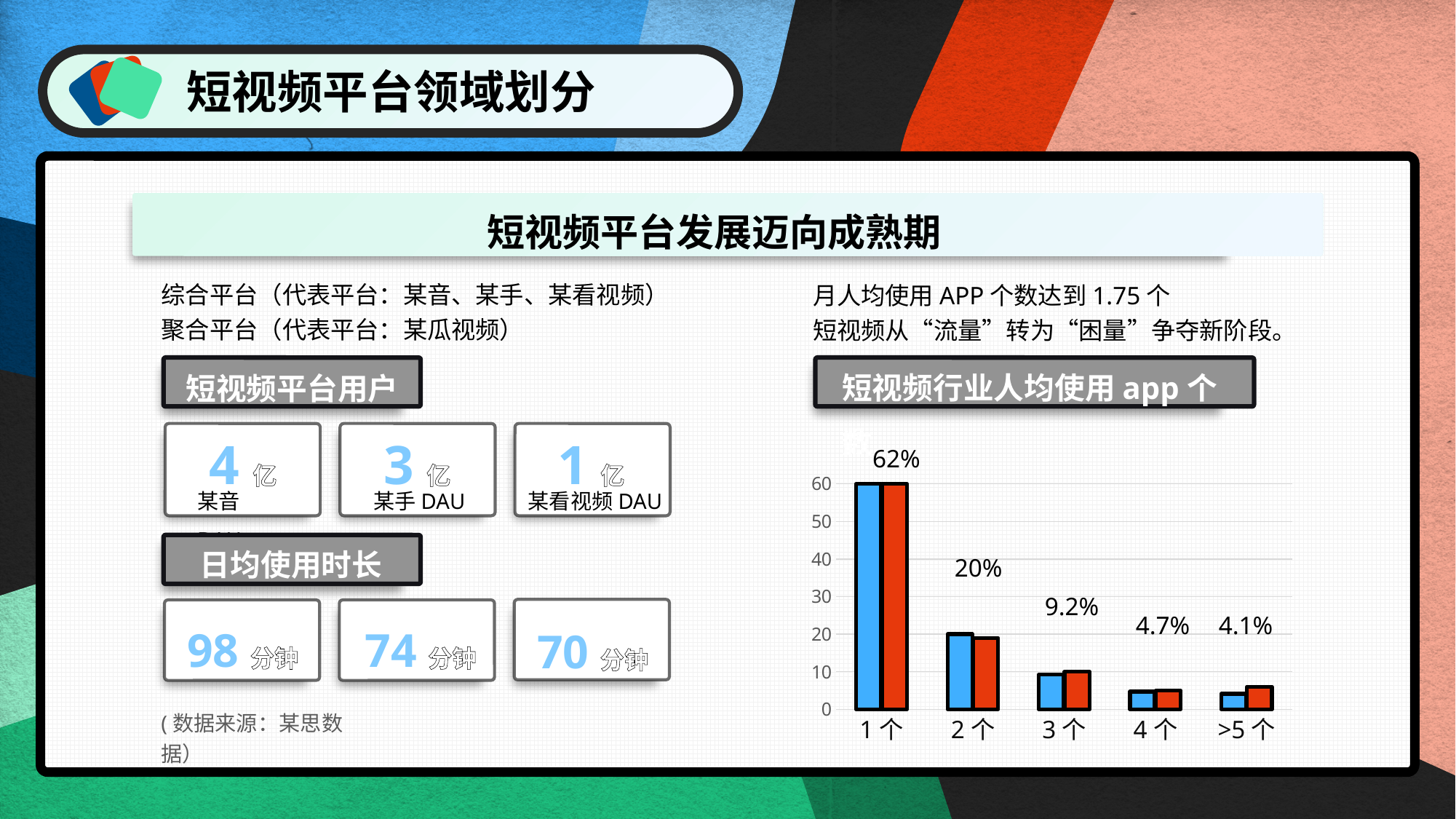
What is the data label shown for the "1 个" category? 62% Do the values rise or fall moving from "1 个" to ">5 个" along the x axis? fall What is the data label shown for the "2 个" category? 20% Which category has the highest value in the chart? 1 个 What is the data label shown for the ">5 个" category? 4.1% Which is larger, the labelled value for "3 个" or for "4 个"? 3 个 What kind of chart is shown on the slide? bar chart Are the bars for "2 个" greater or less than 30 on the axis? less How many categories are shown on the x axis of the chart? 5 What is the data label shown for the "3 个" category? 9.2% What is the difference between the labelled values for "1 个" and "2 个"? 42% Which category has the lowest labelled value in the chart? >5 个